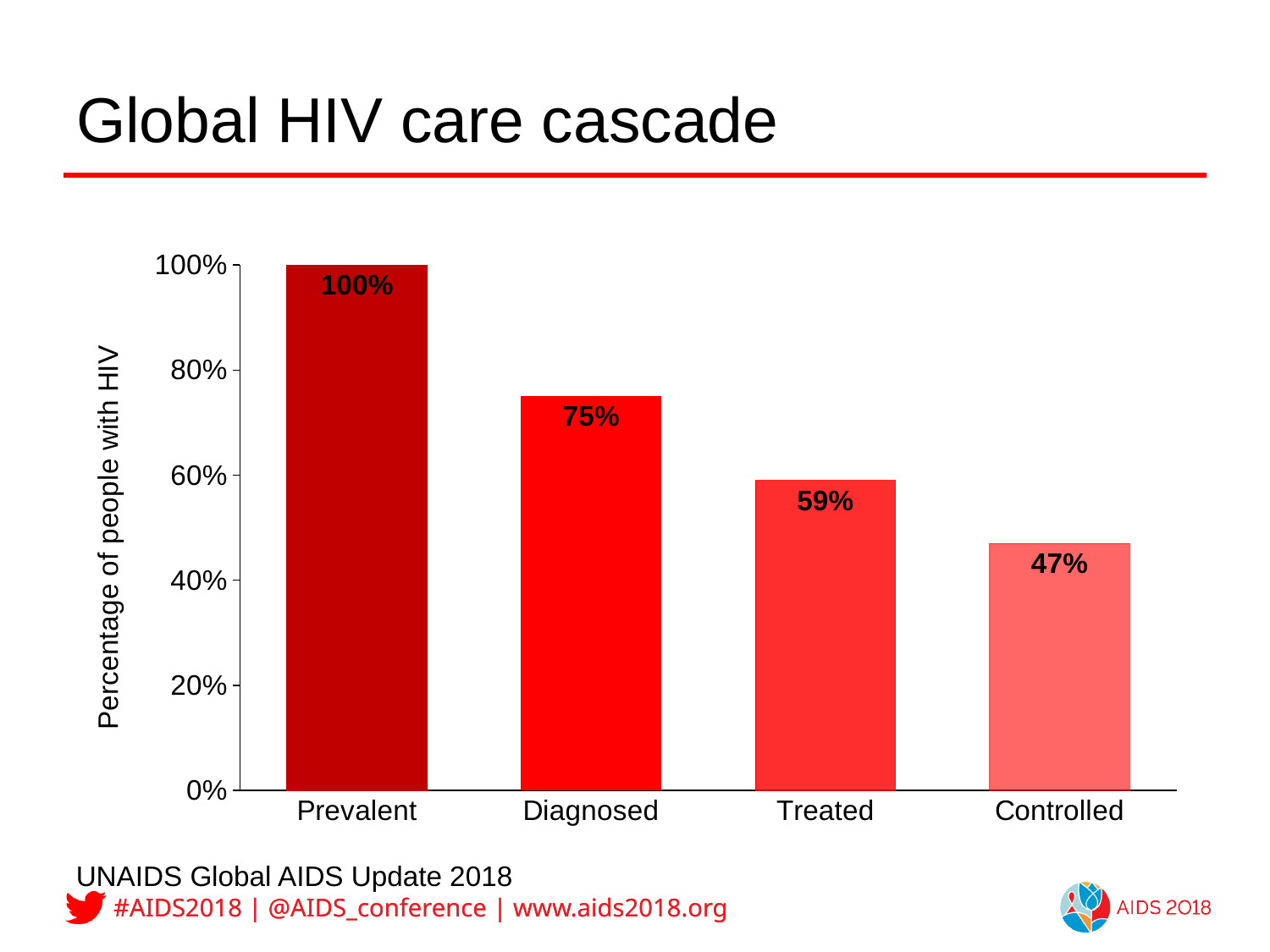
What is the value for Controlled? 47% What is the value for Treated? 59% Which category has the lowest value? Controlled How many categories are shown on the x axis? 4 What is the difference between the values for Prevalent and Controlled? 53% Is the value for Controlled greater or less than 60%? less Which category has the highest value? Prevalent What kind of chart is shown on the slide? bar chart What is the difference between the values for Diagnosed and Treated? 16% Which is larger, the value for Treated or the value for Controlled? Treated What is the value for Diagnosed? 75% Do the values rise or fall from Prevalent to Controlled along the x axis? fall